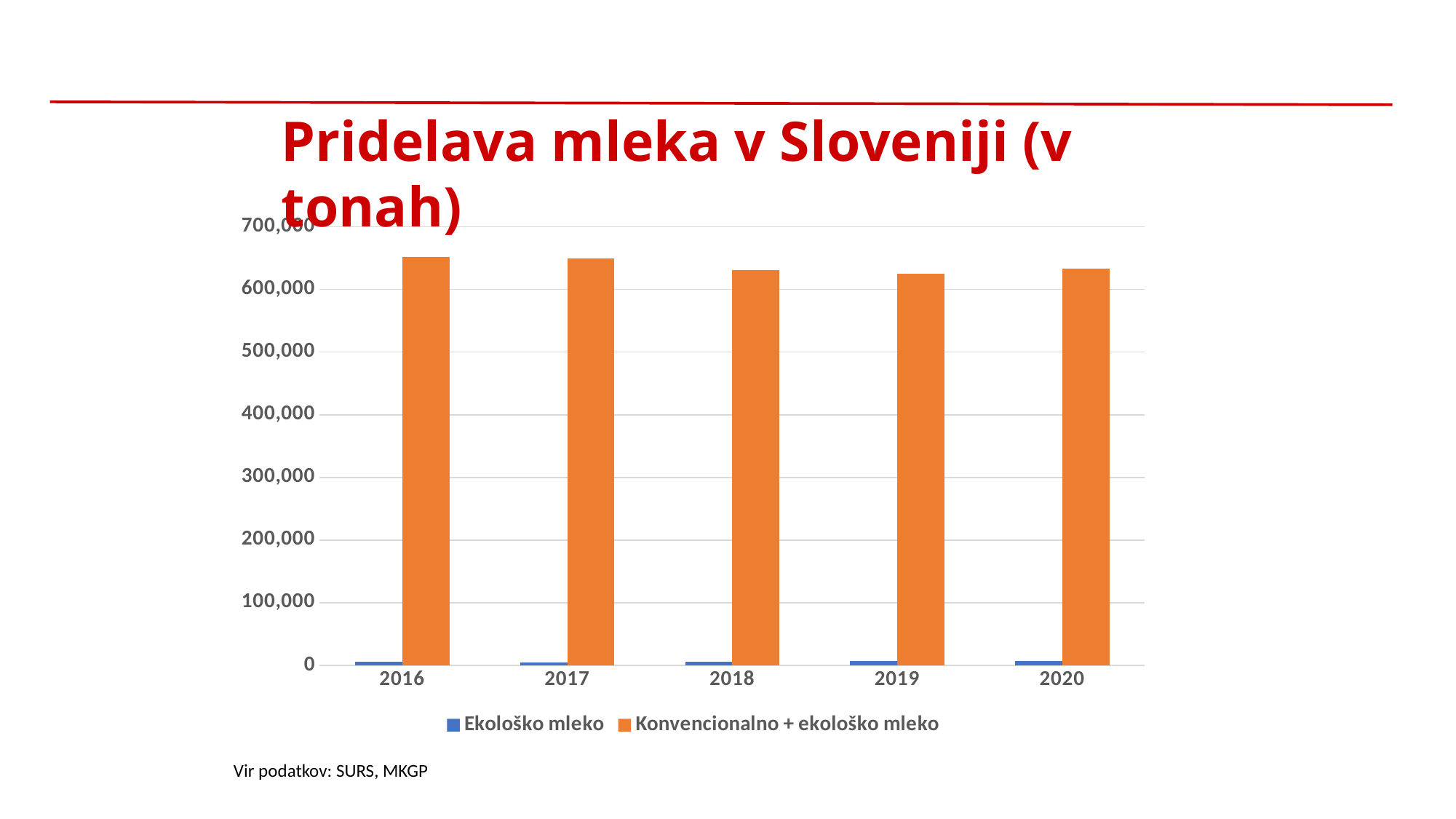
Which is larger: the Konvencionalno + ekološko mleko value for 2017 or for 2018? 2017 Which series has the lower values in every year, Ekološko mleko or Konvencionalno + ekološko mleko? Ekološko mleko Which is larger: the Konvencionalno + ekološko mleko value for 2016 or for 2019? 2016 What is the title of the chart? Pridelava mleka v Sloveniji (v tonah) Is the value for Ekološko mleko in 2018 greater or less than 100,000? less Is the value for Konvencionalno + ekološko mleko in 2019 greater or less than 700,000? less Is the value for Konvencionalno + ekološko mleko in 2016 greater or less than 600,000? greater Which series is shown in orange in the chart? Konvencionalno + ekološko mleko What kind of chart is shown on the slide? bar chart How many series does the chart's legend list? 2 Does the Konvencionalno + ekološko mleko value rise or fall from 2016 to 2019? fall How many years are shown on the x axis of the chart? 5